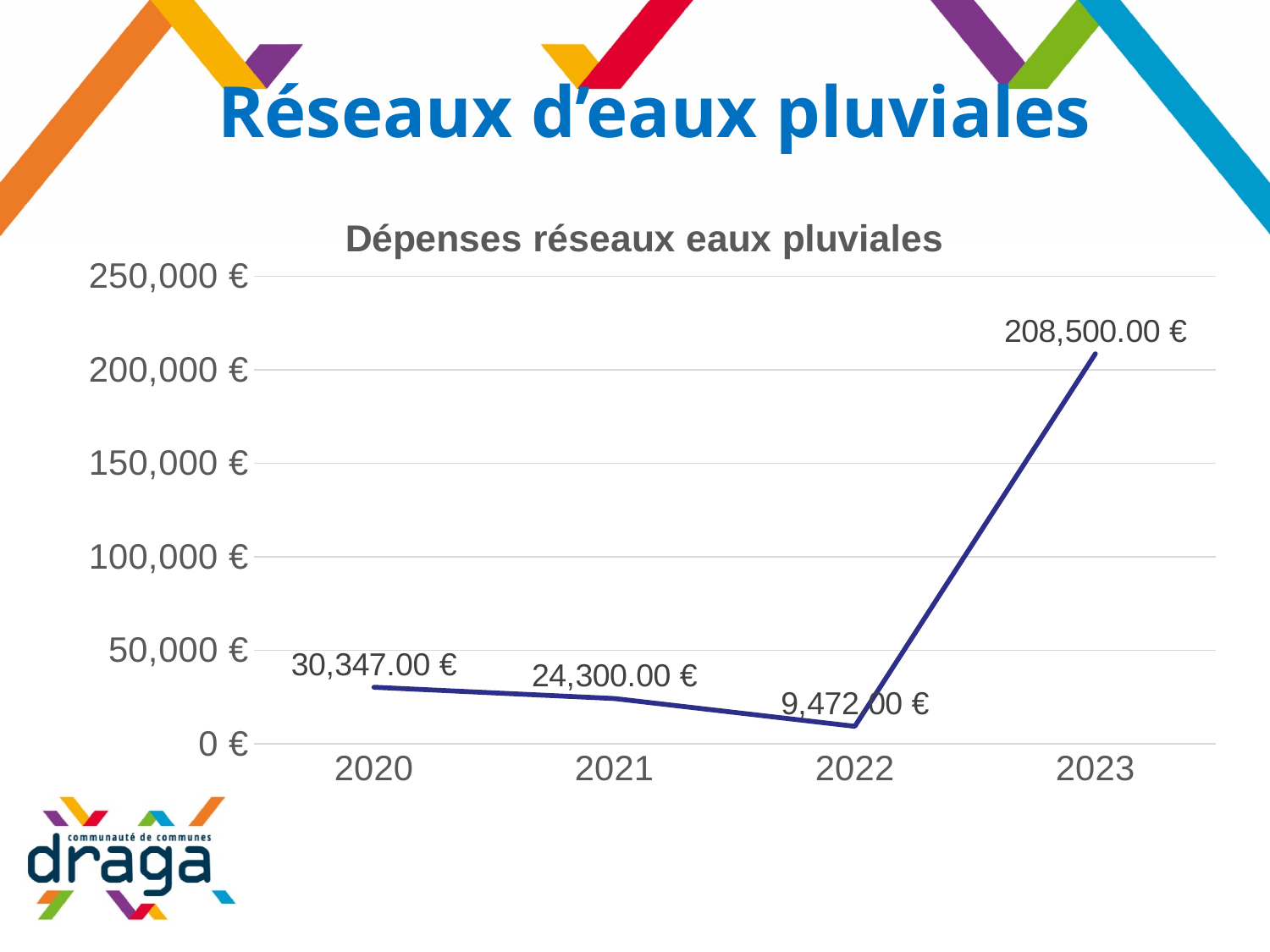
What is the value for 2023? 208,500.00 € What is the difference between the values for 2023 and 2022? 199,028.00 € Which is larger, the value for 2020 or the value for 2021? 2020 What is the value for 2022? 9,472.00 € Which year has the lowest value? 2022 What is the difference between the values for 2020 and 2021? 6,047.00 € What is the value for 2021? 24,300.00 € What kind of chart is shown? line chart What is the value for 2020? 30,347.00 € Is the value for 2023 greater or less than 200,000 €? greater Which year has the highest value? 2023 How many years are plotted on the chart? 4